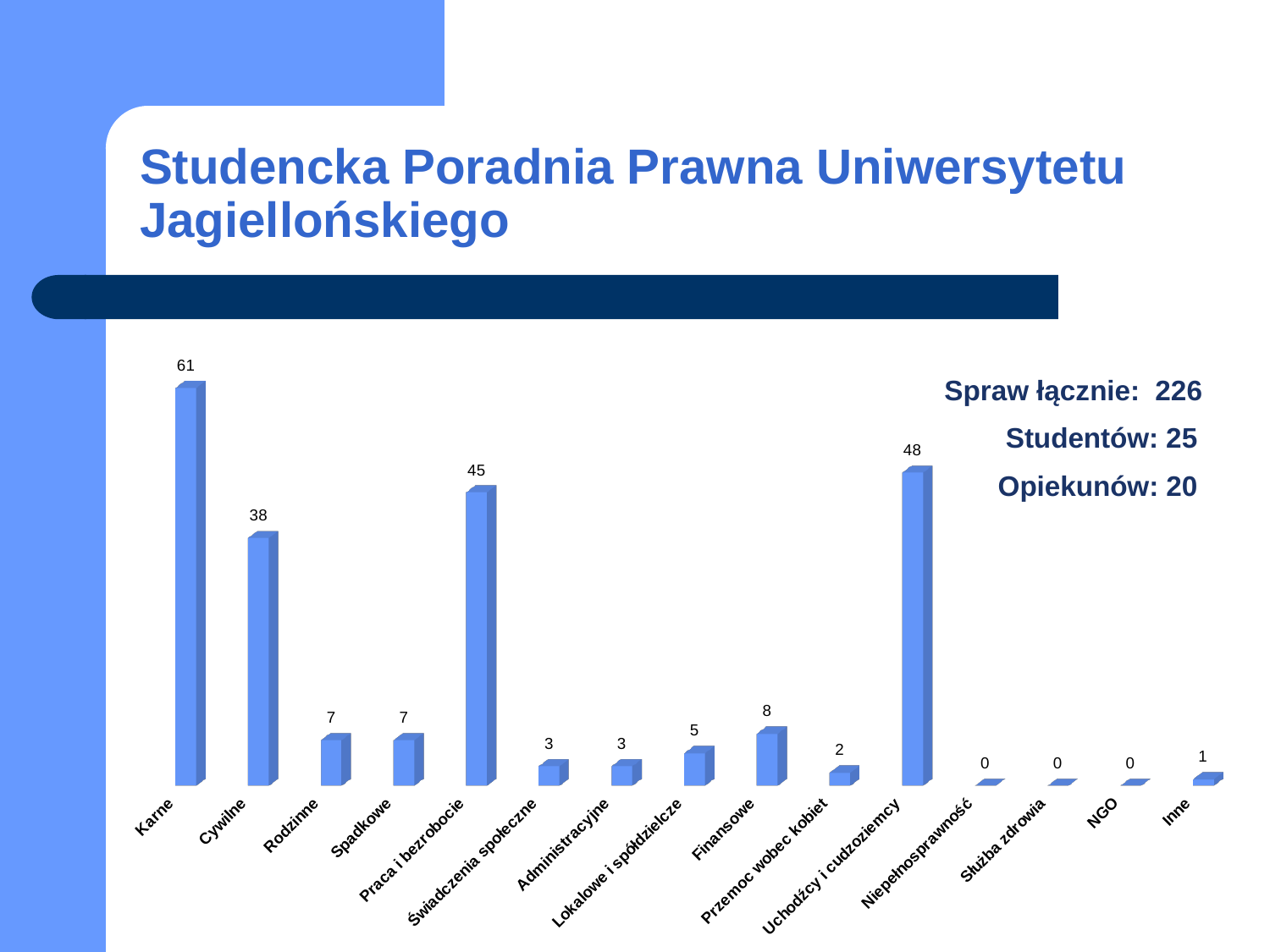
What is the difference between the values for Uchodźcy i cudzoziemcy and Praca i bezrobocie? 3 What is the value for Finansowe? 8 How many categories have a value of 0? 3 What is the value for Karne? 61 What kind of chart is shown on the slide? Bar chart According to the text next to the chart, what is the total number of cases (Spraw łącznie)? 226 Which is larger, the value for Finansowe or the value for Lokalowe i spółdzielcze? Finansowe How many categories are shown on the x axis? 15 What is the difference between the values for Karne and Cywilne? 23 Which category has the highest value? Karne What is the value for Uchodźcy i cudzoziemcy? 48 What is the value for Praca i bezrobocie? 45